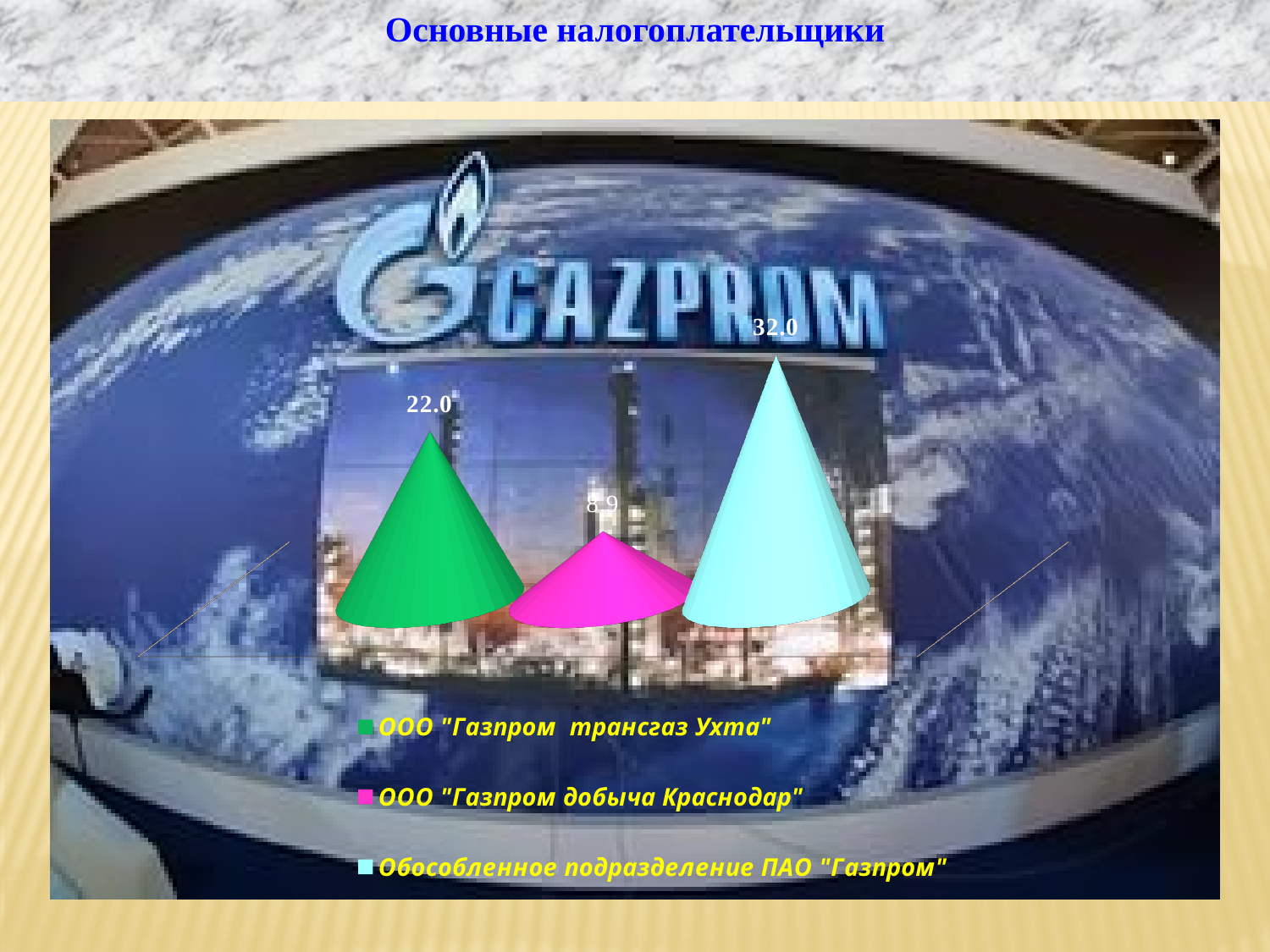
What is the difference between the values for ООО "Газпром трансгаз Ухта" and ООО "Газпром добыча Краснодар"? 13.1 What is the value for ООО "Газпром трансгаз Ухта"? 22.0 How many cones are plotted on the chart? 3 What is the value for Обособленное подразделение ПАО "Газпром"? 32.0 What colour represents ООО "Газпром добыча Краснодар" in the legend? Pink Which is larger, the value for ООО "Газпром трансгаз Ухта" or for ООО "Газпром добыча Краснодар"? ООО "Газпром трансгаз Ухта" What is the value for ООО "Газпром добыча Краснодар"? 8.9 What is the difference between the values for Обособленное подразделение ПАО "Газпром" and ООО "Газпром трансгаз Ухта"? 10.0 Which taxpayer has the highest value? Обособленное подразделение ПАО "Газпром" Which taxpayer has the lowest value? ООО "Газпром добыча Краснодар" How many series does the legend list? 3 What is the title of the slide? Основные налогоплательщики